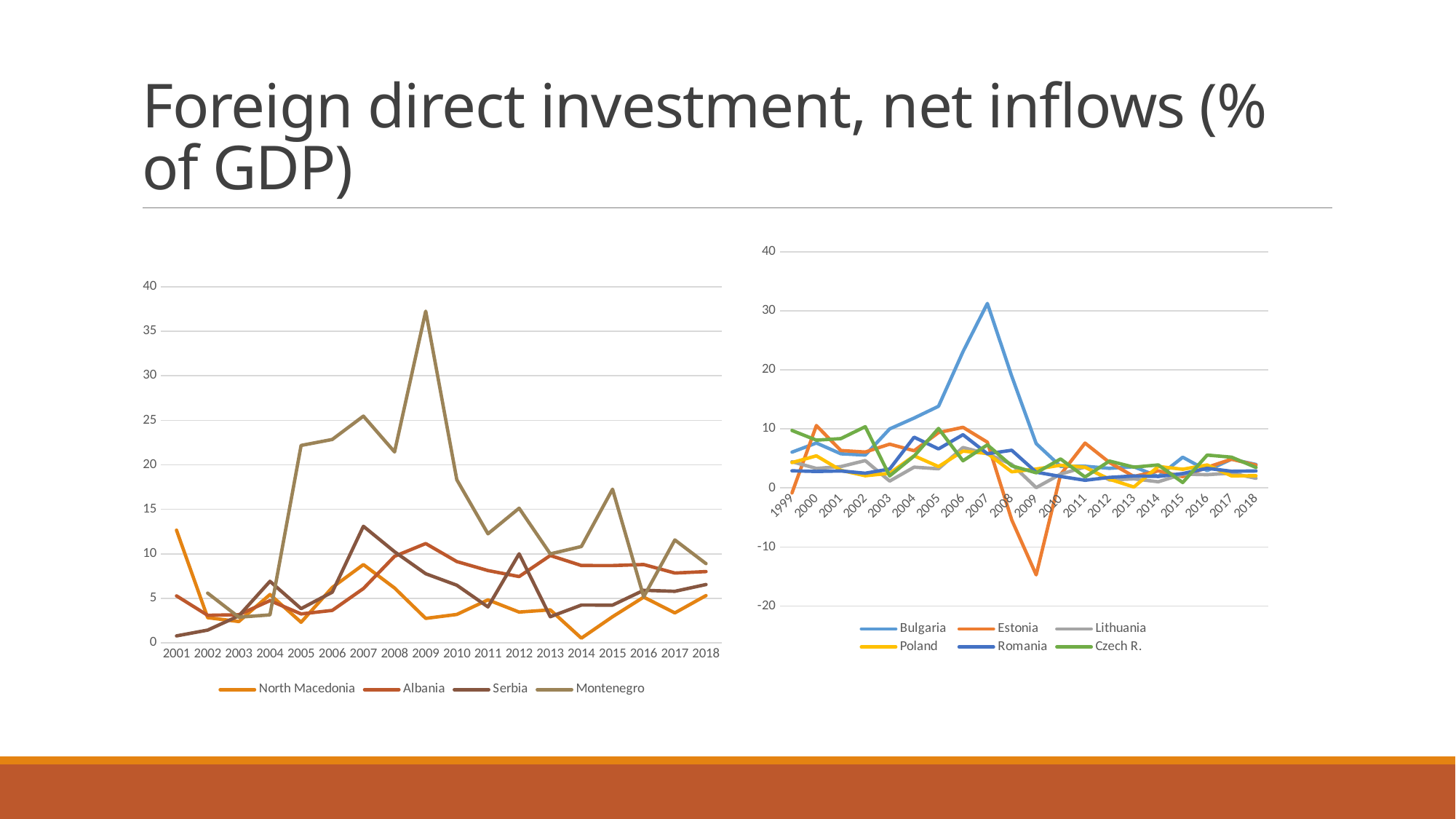
How many years are shown on the x axis of the left chart? 18 How many series does the legend of the right chart list? 6 In the left chart, is the value for Montenegro in 2009 greater or less than 35? greater How many years are shown on the x axis of the right chart? 20 In the right chart, is the value for Bulgaria in 2007 greater or less than 30? greater In the left chart, which series reaches the highest value? Montenegro In the left chart, in which year does Montenegro reach its highest value? 2009 What kind of chart is the left chart on the slide? line chart In the right chart, is the value for Estonia in 2009 greater or less than -10? less In the right chart, does the Bulgaria line rise or fall between 2007 and 2009? fall How many series does the legend of the left chart list? 4 In the right chart, which series reaches the highest value? Bulgaria